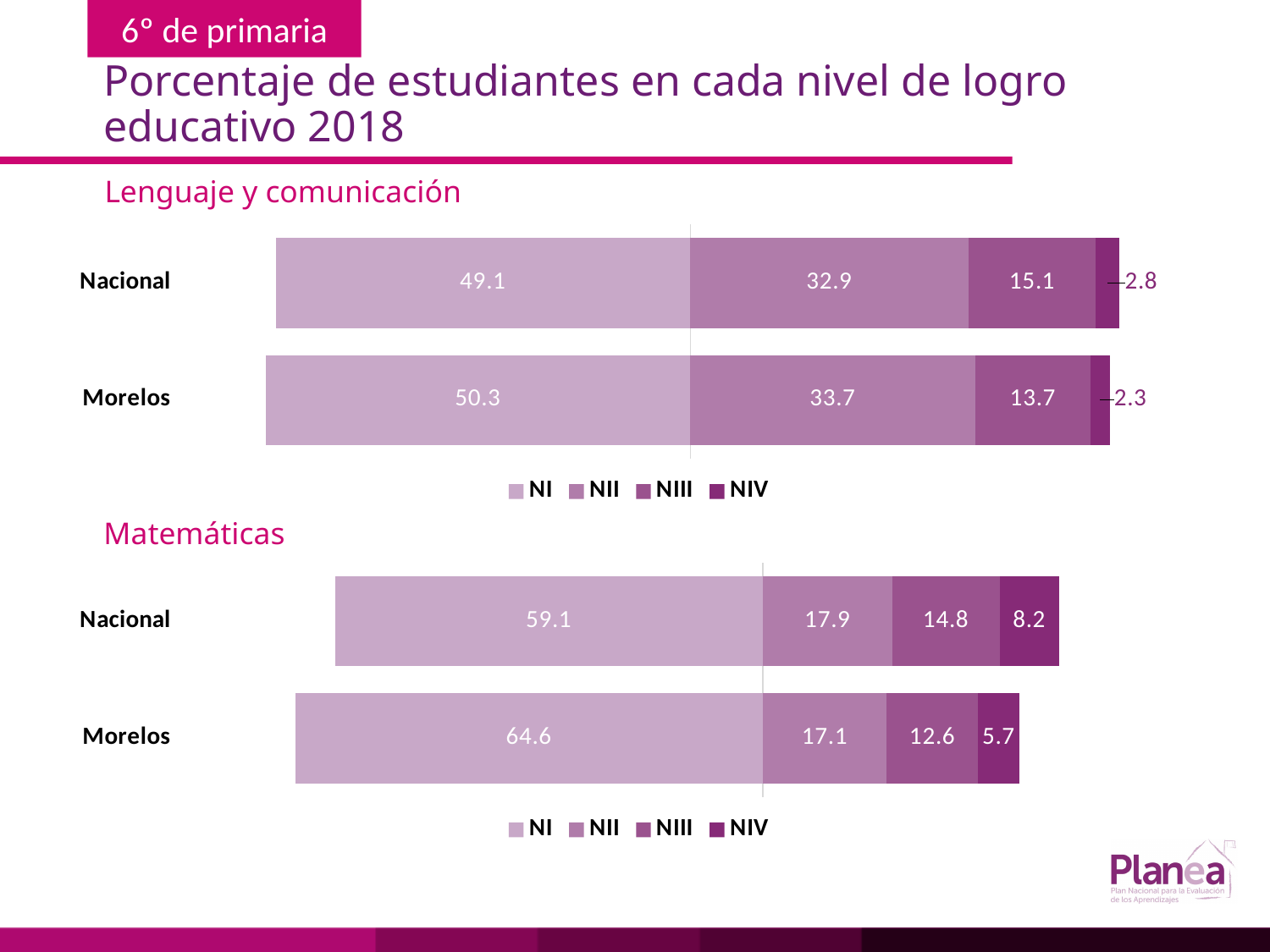
In the Lenguaje y comunicación chart, what is the NI value for Nacional? 49.1 How many series does the legend of the Matemáticas chart list? 4 In the Matemáticas chart, what is the NI value for Morelos? 64.6 In the Matemáticas chart, which level has the highest value for Morelos? NI How many categories are shown in the Lenguaje y comunicación chart? 2 In the Lenguaje y comunicación chart, which level has the lowest value for Nacional? NIV What kind of chart is the Lenguaje y comunicación chart? Stacked bar chart In the Lenguaje y comunicación chart, what is the NIV value for Morelos? 2.3 In the Lenguaje y comunicación chart, which is larger, the NII value for Nacional or for Morelos? Morelos In the Matemáticas chart, what is the total of the stacked bar for Nacional? 100.0 In the Matemáticas chart, what is the NIII value for Nacional? 14.8 In the Matemáticas chart, what is the difference between the NI values for Morelos and Nacional? 5.5